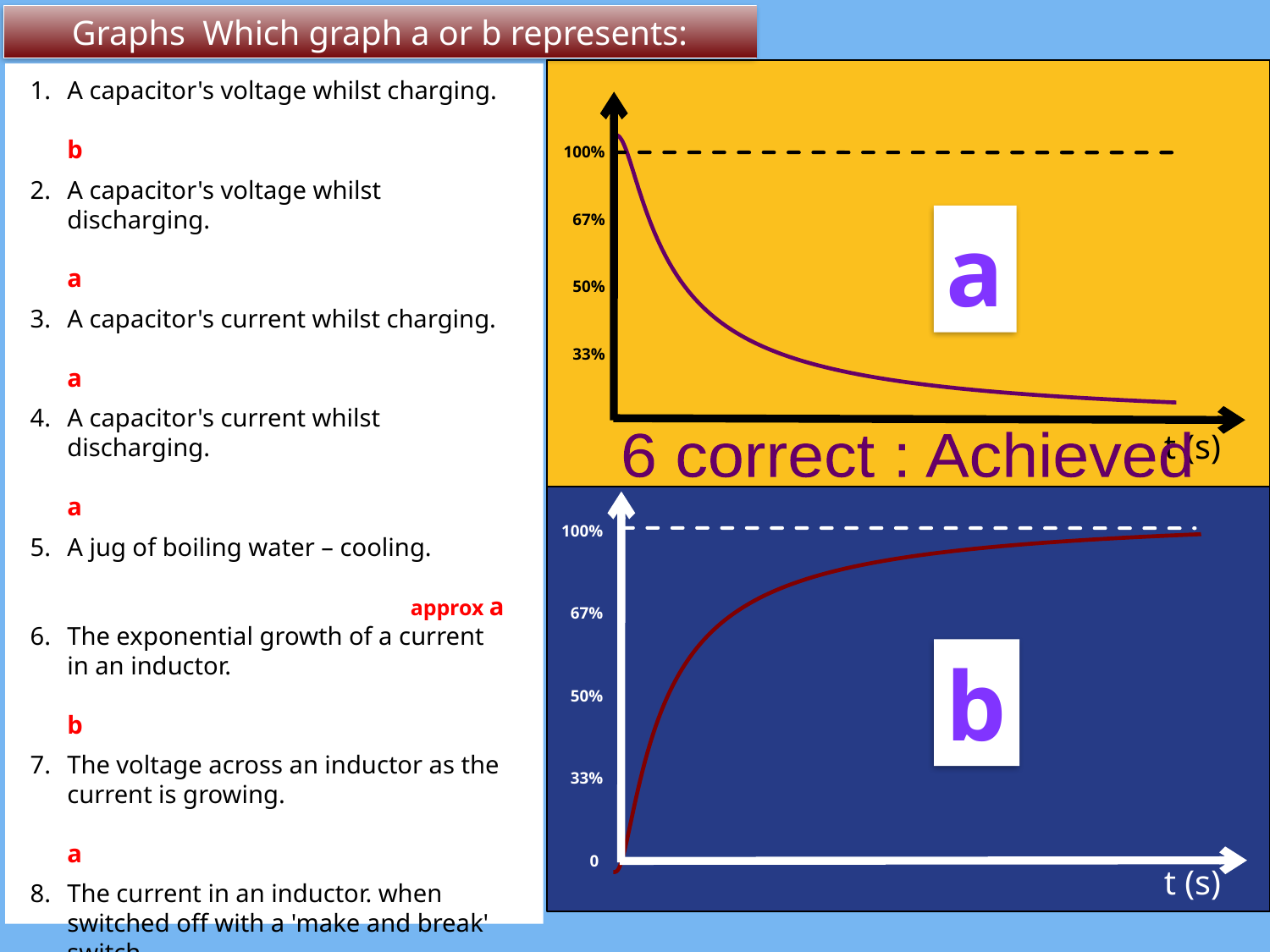
In graph b, what value does the curve start at when t = 0? 0 Which graph, a or b, has the curve that approaches the 100% dashed line as t increases? b What kind of chart is graph a on the slide? line chart In graph b, does the plotted curve rise or fall as t increases? rise At what percentage level is the dashed horizontal line drawn in graph b? 100% How many graphs are shown on the slide? 2 In graph b, is the value of the curve at the far right end of the time axis greater or less than 67%? greater In graph a, does the plotted curve rise or fall as t increases? fall What is the highest percentage tick shown on the vertical axis of graph a? 100% In graph a, is the value of the curve at the far right end of the time axis greater or less than 33%? less What kind of chart is graph b on the slide? line chart What is the label on the horizontal axis of graph b? t (s)